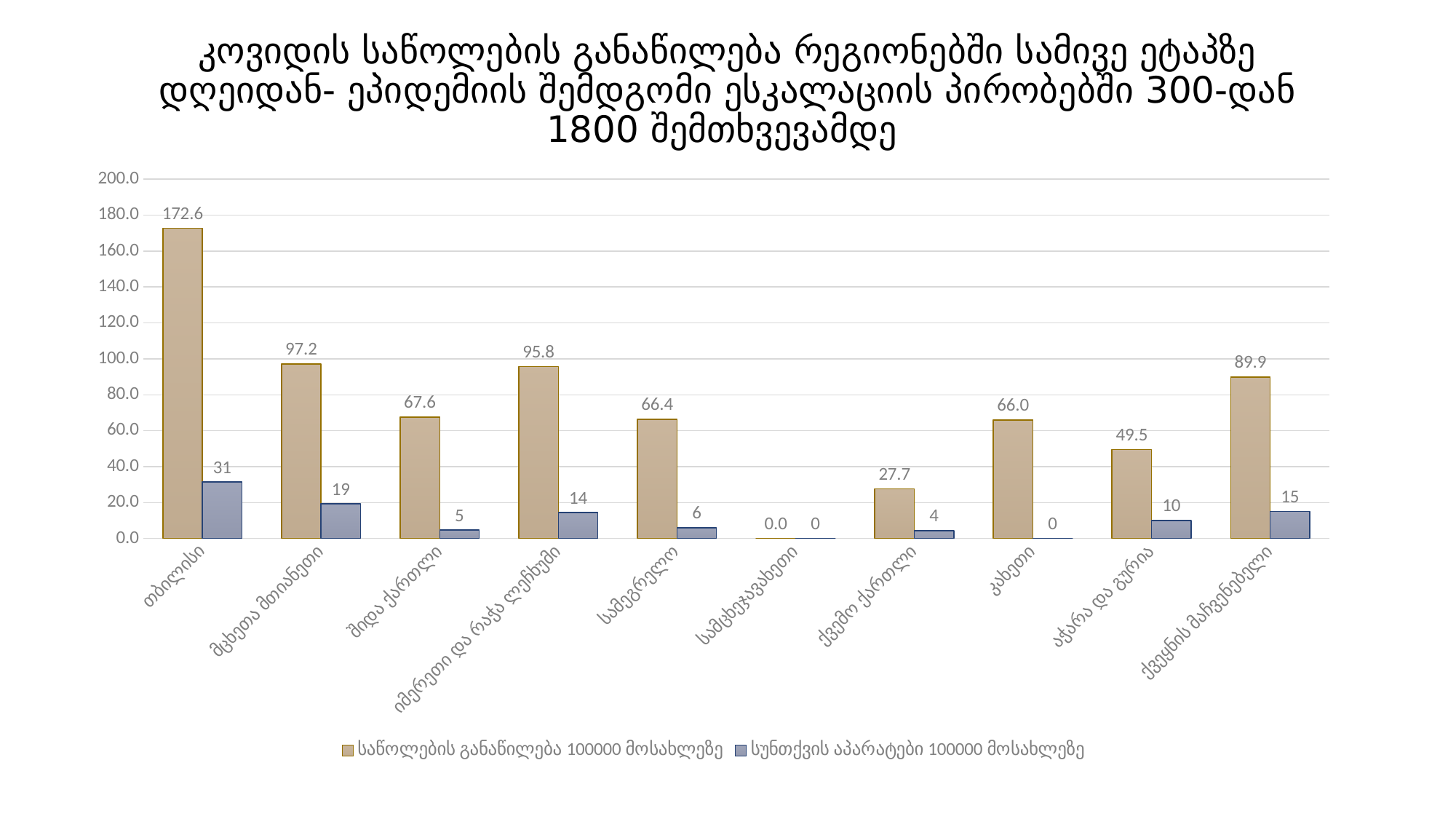
Is the value of საწოლების განაწილება 100000 მოსახლეზე for ქვემო ქართლი greater or less than 40.0? less Which category has the highest value for საწოლების განაწილება 100000 მოსახლეზე? თბილისი What is the value of საწოლების განაწილება 100000 მოსახლეზე for თბილისი? 172.6 What is the difference between the საწოლების განაწილება 100000 მოსახლეზე values for თბილისი and მცხეთა მთიანეთი? 75.4 Which category has the highest value for სუნთქვის აპარატები 100000 მოსახლეზე? თბილისი How many series does the legend list? 2 What is the value of სუნთქვის აპარატები 100000 მოსახლეზე for კახეთი? 0 What kind of chart is shown on the slide? bar chart What is the value of სუნთქვის აპარატები 100000 მოსახლეზე for მცხეთა მთიანეთი? 19 What is the value of საწოლების განაწილება 100000 მოსახლეზე for ქვეყნის მაჩვენებელი? 89.9 How many categories are shown on the x axis? 10 Which is larger for სუნთქვის აპარატები 100000 მოსახლეზე: იმერეთი და რაჭა ლეჩხუმი or აჭარა და გურია? იმერეთი და რაჭა ლეჩხუმი